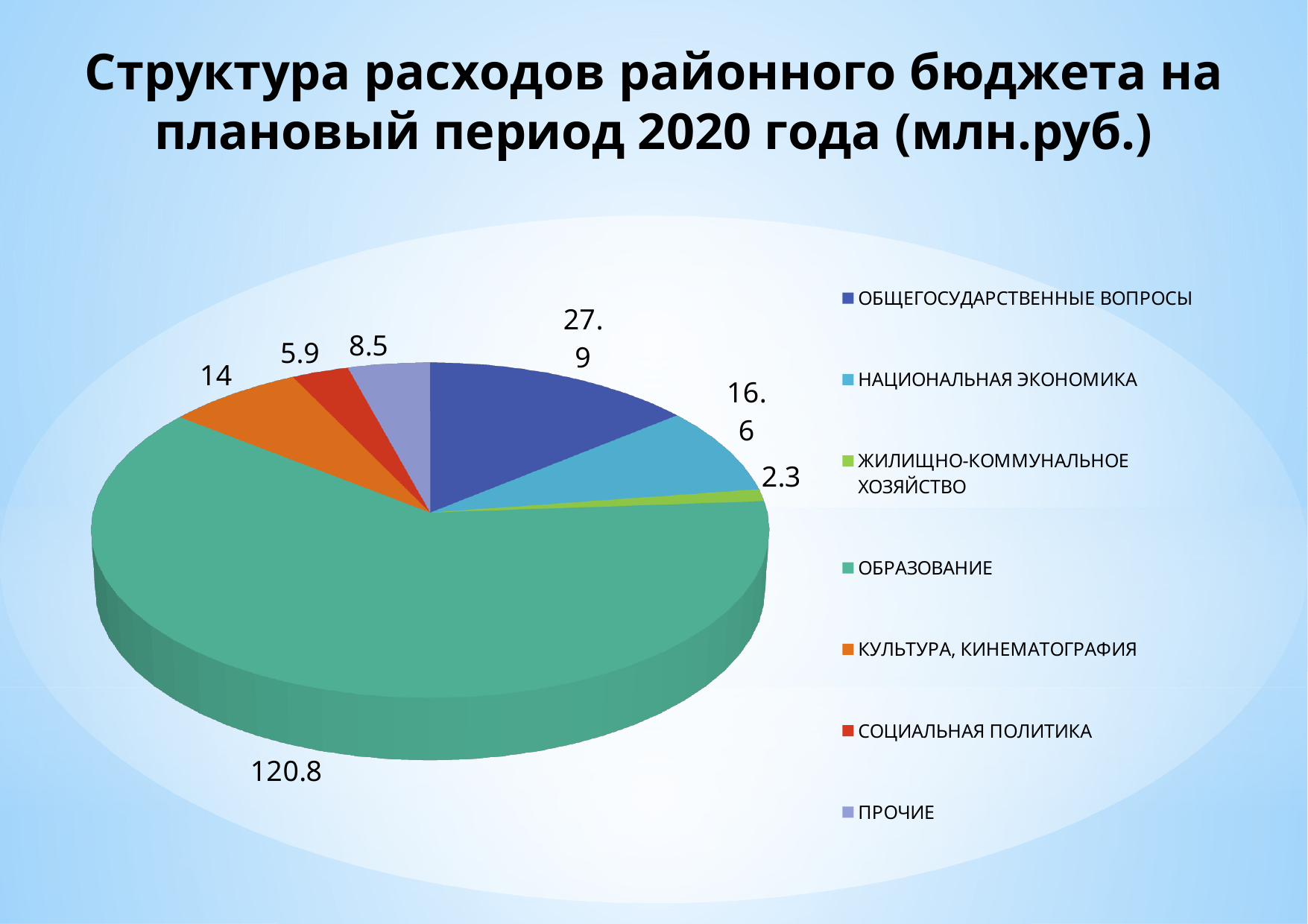
What is the value for КУЛЬТУРА, КИНЕМАТОГРАФИЯ? 14 What is the value for ЖИЛИЩНО-КОММУНАЛЬНОЕ ХОЗЯЙСТВО? 2.3 Which category has the largest slice of the pie? ОБРАЗОВАНИЕ How many categories does the legend list? 7 What type of chart is shown on the slide? Pie chart What is the value for ОБРАЗОВАНИЕ? 120.8 What is the value for ОБЩЕГОСУДАРСТВЕННЫЕ ВОПРОСЫ? 27.9 What is the value for НАЦИОНАЛЬНАЯ ЭКОНОМИКА? 16.6 Which is larger, the value for ПРОЧИЕ or the value for СОЦИАЛЬНАЯ ПОЛИТИКА? ПРОЧИЕ What is the title of the chart on the slide? Структура расходов районного бюджета на плановый период 2020 года (млн.руб.) What is the difference between the values for ОБЩЕГОСУДАРСТВЕННЫЕ ВОПРОСЫ and НАЦИОНАЛЬНАЯ ЭКОНОМИКА? 11.3 Which category has the smallest slice of the pie? ЖИЛИЩНО-КОММУНАЛЬНОЕ ХОЗЯЙСТВО